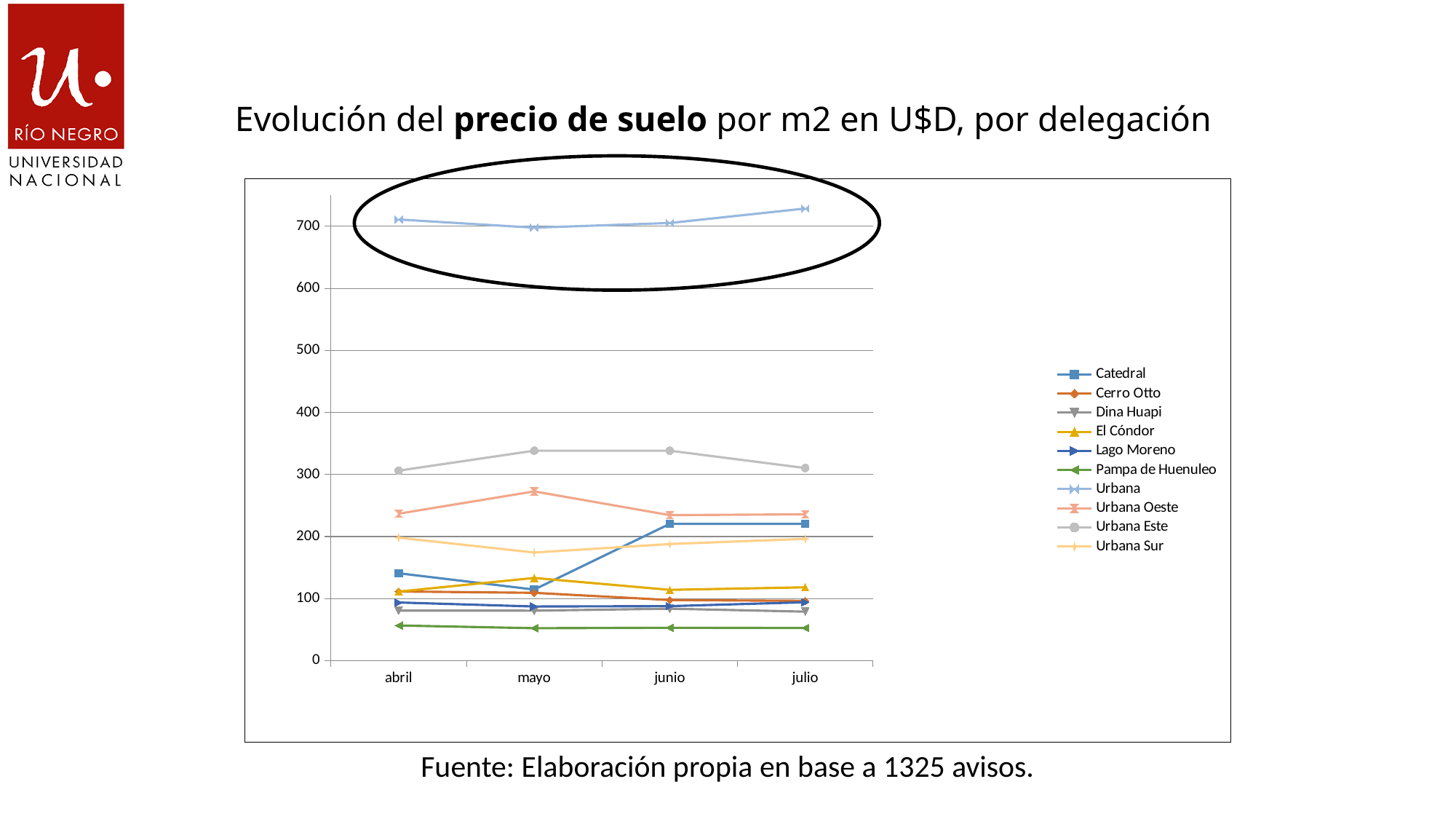
Does the value for Catedral rise or fall from mayo to junio? rise Which delegación has the lowest land price per m2 across all months? Pampa de Huenuleo Is the value for Urbana Este in mayo greater or less than 300? greater What kind of chart is shown on the slide? line chart Which delegación has the highest land price per m2 across all months? Urbana Is the value for Urbana in julio greater or less than 700? greater In junio, which is larger: Urbana Este or Urbana Oeste? Urbana Este Is the value for Pampa de Huenuleo in abril greater or less than 100? less In which month does Urbana Oeste reach its highest value? mayo How many months are shown on the x axis of the chart? 4 How many series does the chart's legend list? 10